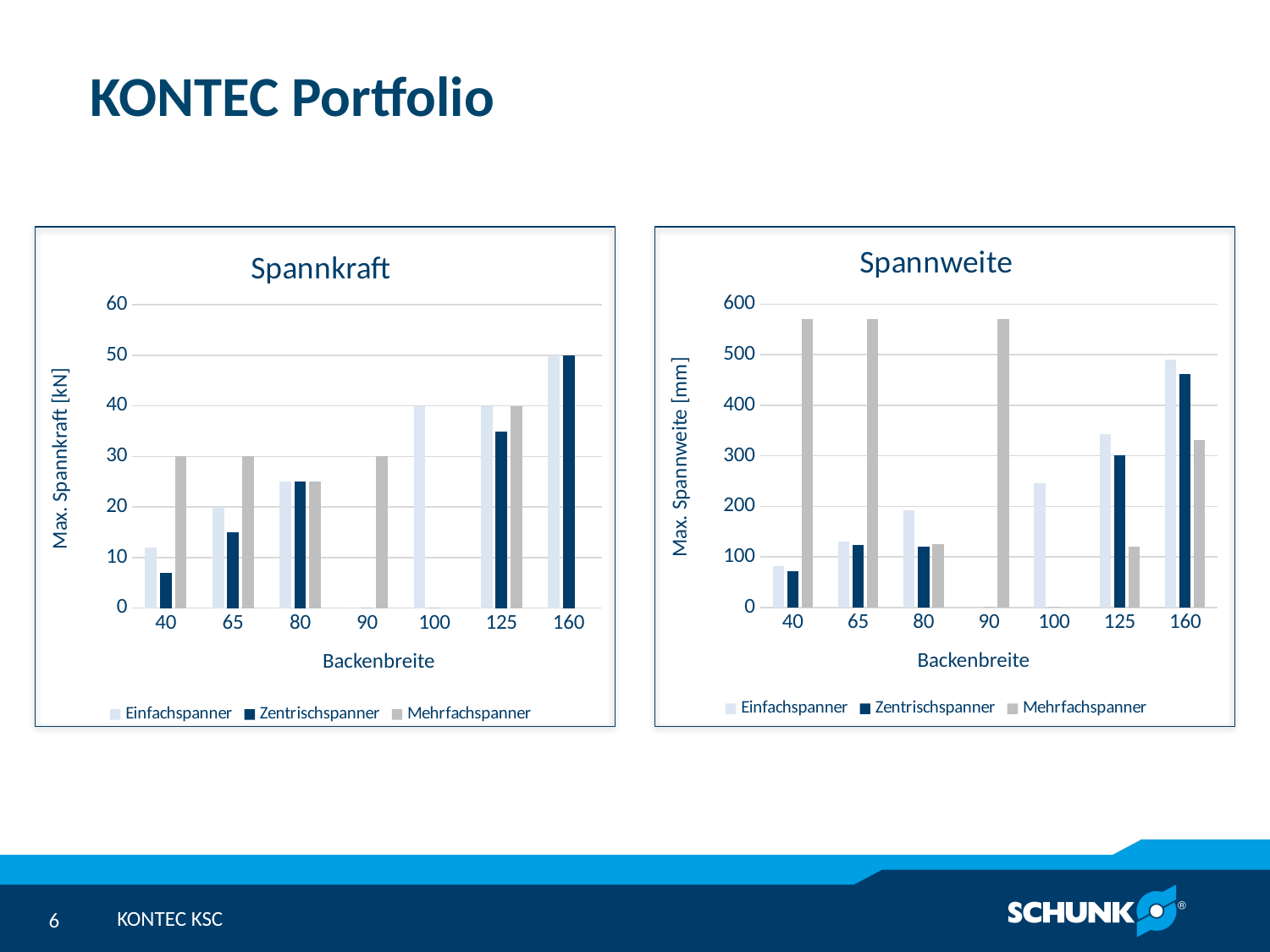
What is the y-axis label of the Spannweite chart? Max. Spannweite [mm] How many Backenbreite categories are shown on the x axis of the Spannkraft chart? 7 In the Spannweite chart, is the value for Mehrfachspanner at Backenbreite 40 greater or less than 500? greater In the Spannkraft chart, is the value for Zentrischspanner at Backenbreite 40 greater or less than 10? less In the Spannweite chart, which series has the lowest value at Backenbreite 125? Mehrfachspanner What type of chart is the Spannkraft chart? bar chart In the Spannkraft chart, which series has the highest value at Backenbreite 65? Mehrfachspanner In the Spannweite chart, is the value for Einfachspanner at Backenbreite 160 larger or smaller than the value for Zentrischspanner at Backenbreite 160? larger How many series does the legend of the Spannweite chart list? 3 In the Spannkraft chart, what is the value for Einfachspanner at Backenbreite 160? 50 In the Spannkraft chart, what is the value for Mehrfachspanner at Backenbreite 90? 30 In the Spannkraft chart, what is the value for Einfachspanner at Backenbreite 100? 40